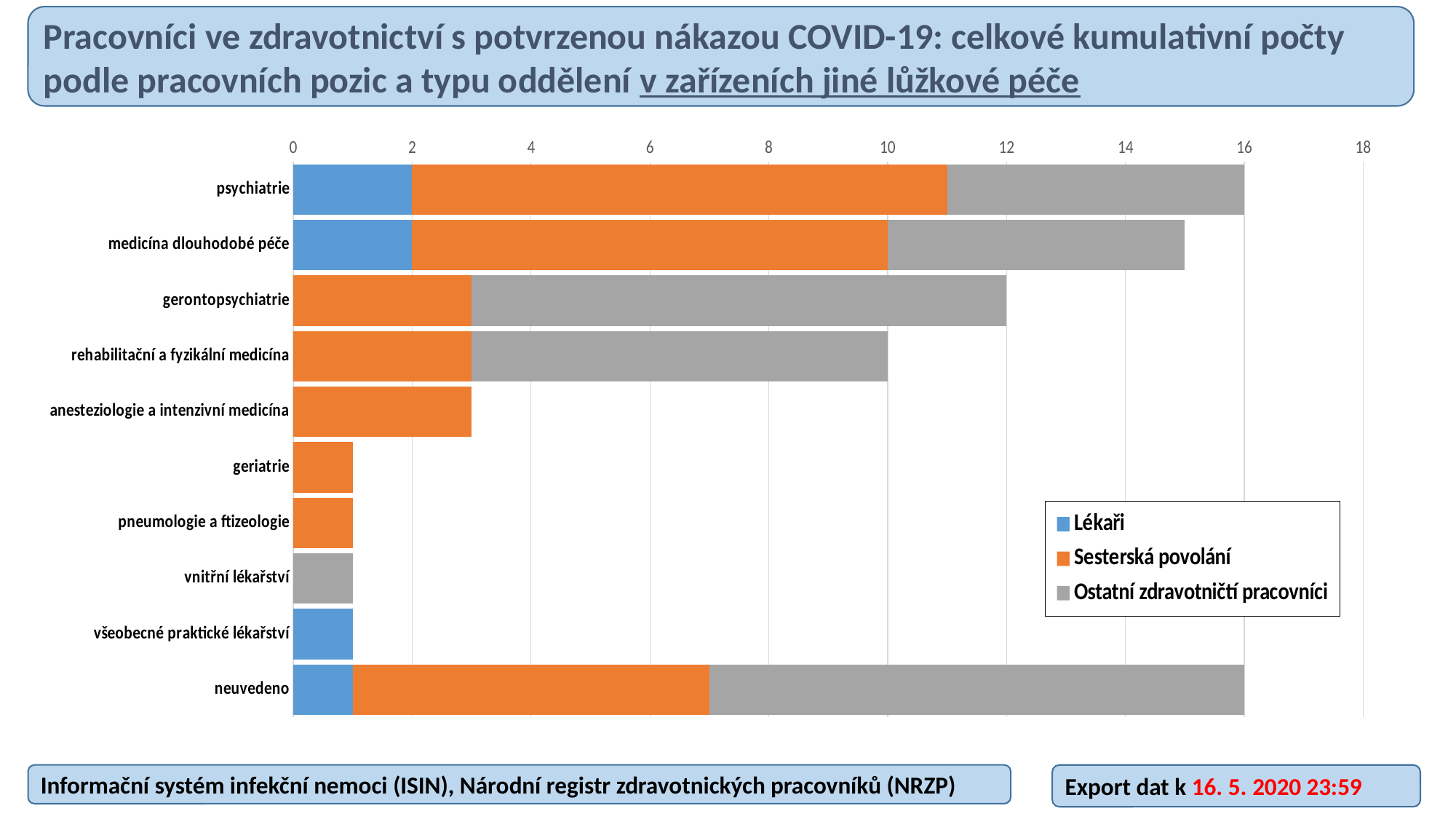
How many department categories are shown on the vertical axis? 10 How many series does the legend list? 3 What is the Lékaři value for psychiatrie? 2 What kind of chart is shown on the slide? stacked bar chart What is the total length of the stacked bar for rehabilitační a fyzikální medicína? 10 Which has a larger total, gerontopsychiatrie or rehabilitační a fyzikální medicína? gerontopsychiatrie Is the total for anesteziologie a intenzivní medicína greater or less than 4? less Is the total for medicína dlouhodobé péče greater or less than 14? greater What is the total length of the stacked bar for gerontopsychiatrie? 12 What is the total length of the stacked bar for psychiatrie? 16 What is the difference between the totals for gerontopsychiatrie and rehabilitační a fyzikální medicína? 2 Which series is shown in orange in the legend? Sesterská povolání